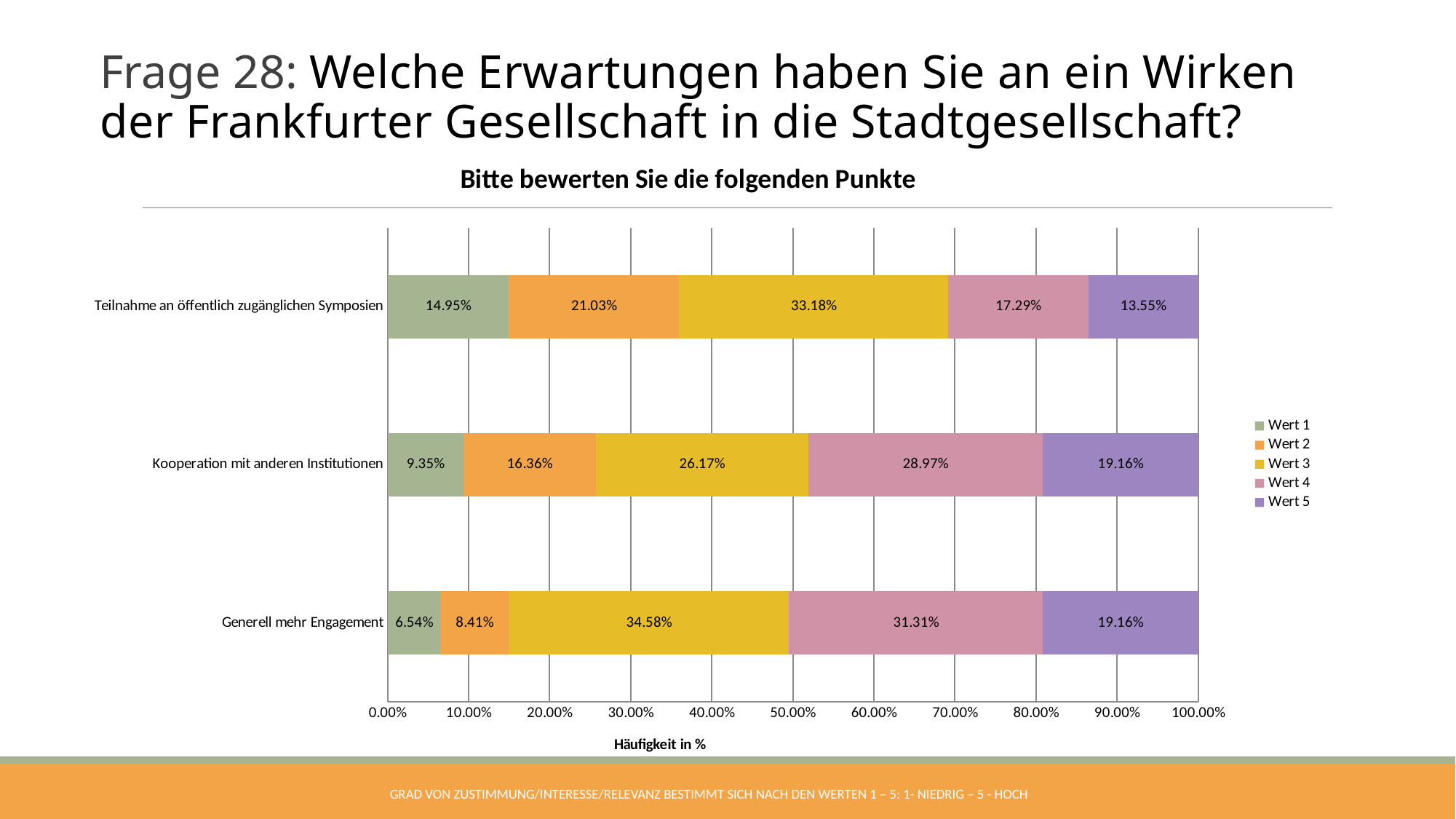
What is the title of the chart? Bitte bewerten Sie die folgenden Punkte Which category has the highest value for Wert 1? Teilnahme an öffentlich zugänglichen Symposien Which is larger: Wert 5 for 'Kooperation mit anderen Institutionen' or Wert 5 for 'Teilnahme an öffentlich zugänglichen Symposien'? Kooperation mit anderen Institutionen How many categories are shown on the chart? 3 What is the difference between the Wert 4 values for 'Generell mehr Engagement' and 'Teilnahme an öffentlich zugänglichen Symposien'? 14.02% What is the label of the x axis? Häufigkeit in % What is the value for Wert 1 in the 'Generell mehr Engagement' bar? 6.54% What is the value for Wert 4 in the 'Kooperation mit anderen Institutionen' bar? 28.97% What kind of chart is shown on the slide? Stacked bar chart What is the value for Wert 3 in the 'Teilnahme an öffentlich zugänglichen Symposien' bar? 33.18% Which category has the lowest value for Wert 2? Generell mehr Engagement How many series does the legend list? 5